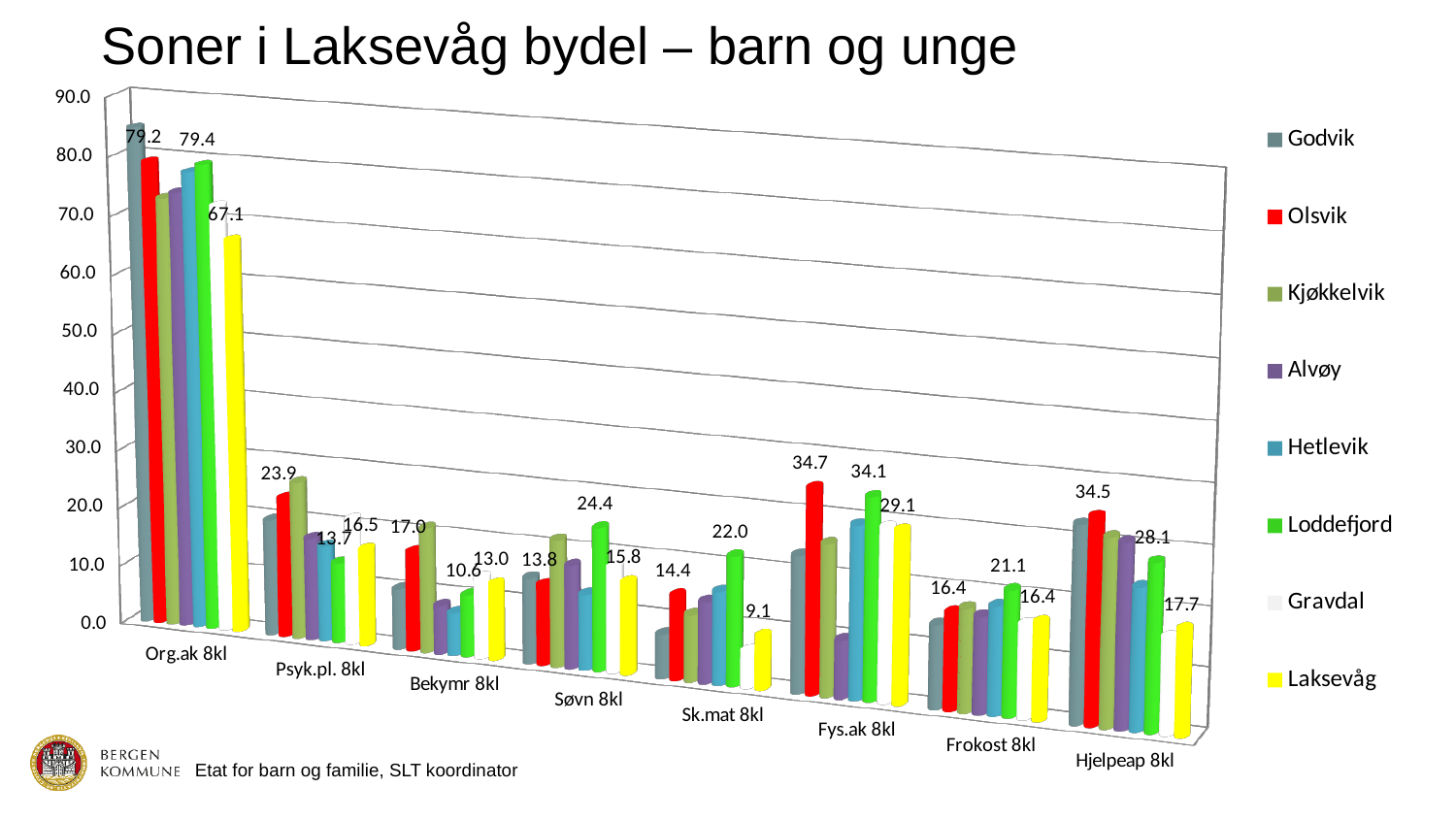
How many series does the legend list? 8 For Laksevåg, which is larger: the value for Psyk.pl. 8kl or for Bekymr 8kl? Psyk.pl. 8kl Which category has the highest values across all zones? Org.ak 8kl In which category is the Laksevåg value lowest? Sk.mat 8kl Is the value for Godvik in the Org.ak 8kl category greater or less than 80.0? greater What is the value for Loddefjord in the Søvn 8kl category? 24.4 What is the difference between the Laksevåg values for Org.ak 8kl and Hjelpeap 8kl? 49.4 What is the value for Laksevåg in the Org.ak 8kl category? 67.1 What is the value for Laksevåg in the Fys.ak 8kl category? 29.1 How many categories are shown along the x axis? 8 What is the value for Laksevåg in the Sk.mat 8kl category? 9.1 What kind of chart is shown on the slide? bar chart